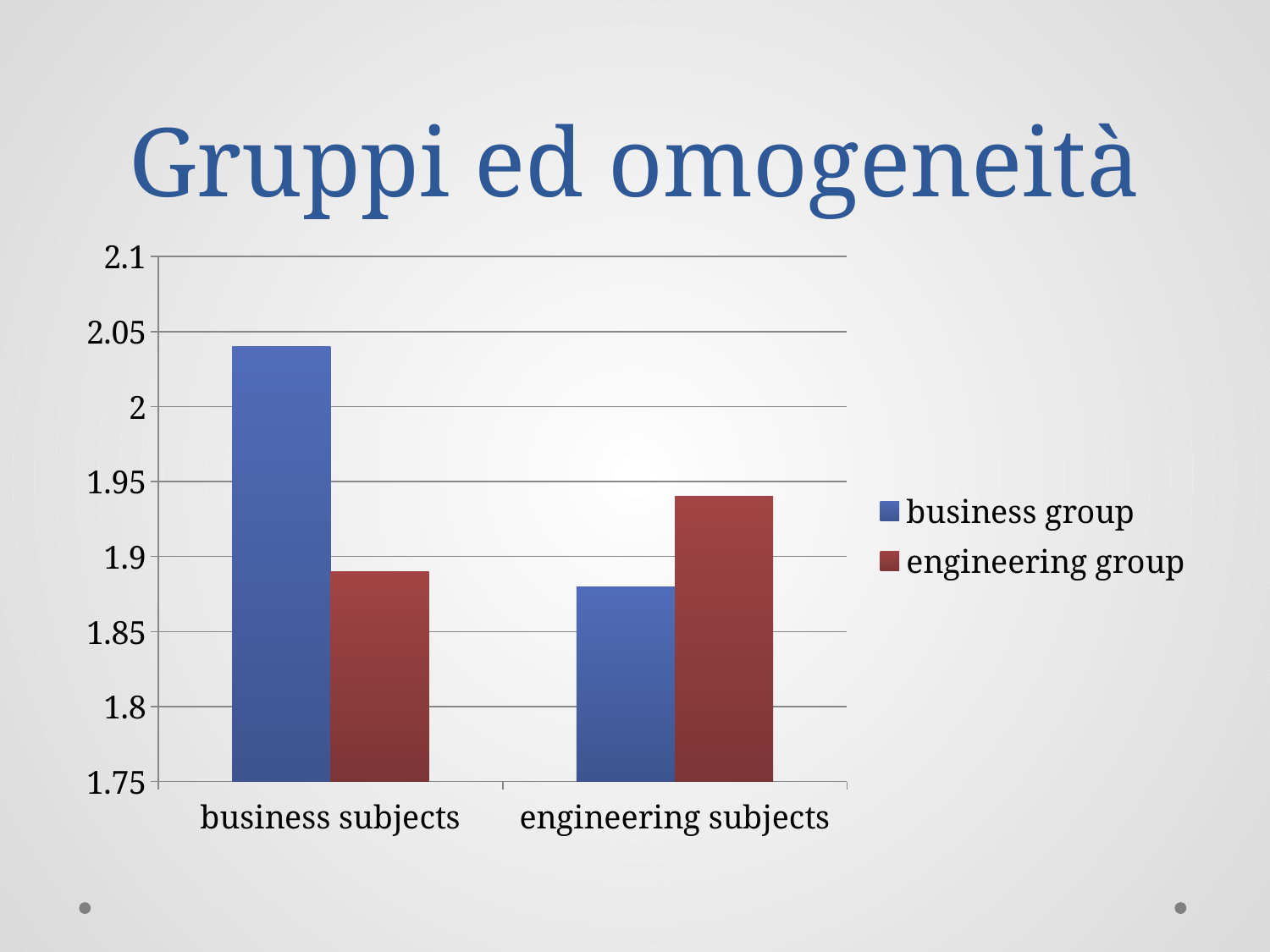
Is the value for the business group on business subjects greater or less than 2? greater Is the value for the business group on engineering subjects greater or less than 1.9? less Which series is shown in red? engineering group Is the value for the engineering group on business subjects greater or less than 1.9? less How many series does the legend list? 2 What kind of chart is shown on the slide? bar chart What is the title of the slide containing the chart? Gruppi ed omogeneità Which bar is the highest in the chart? business group on business subjects For business subjects, which group has the larger value? business group How many categories are shown on the x axis? 2 For engineering subjects, which group has the larger value? engineering group